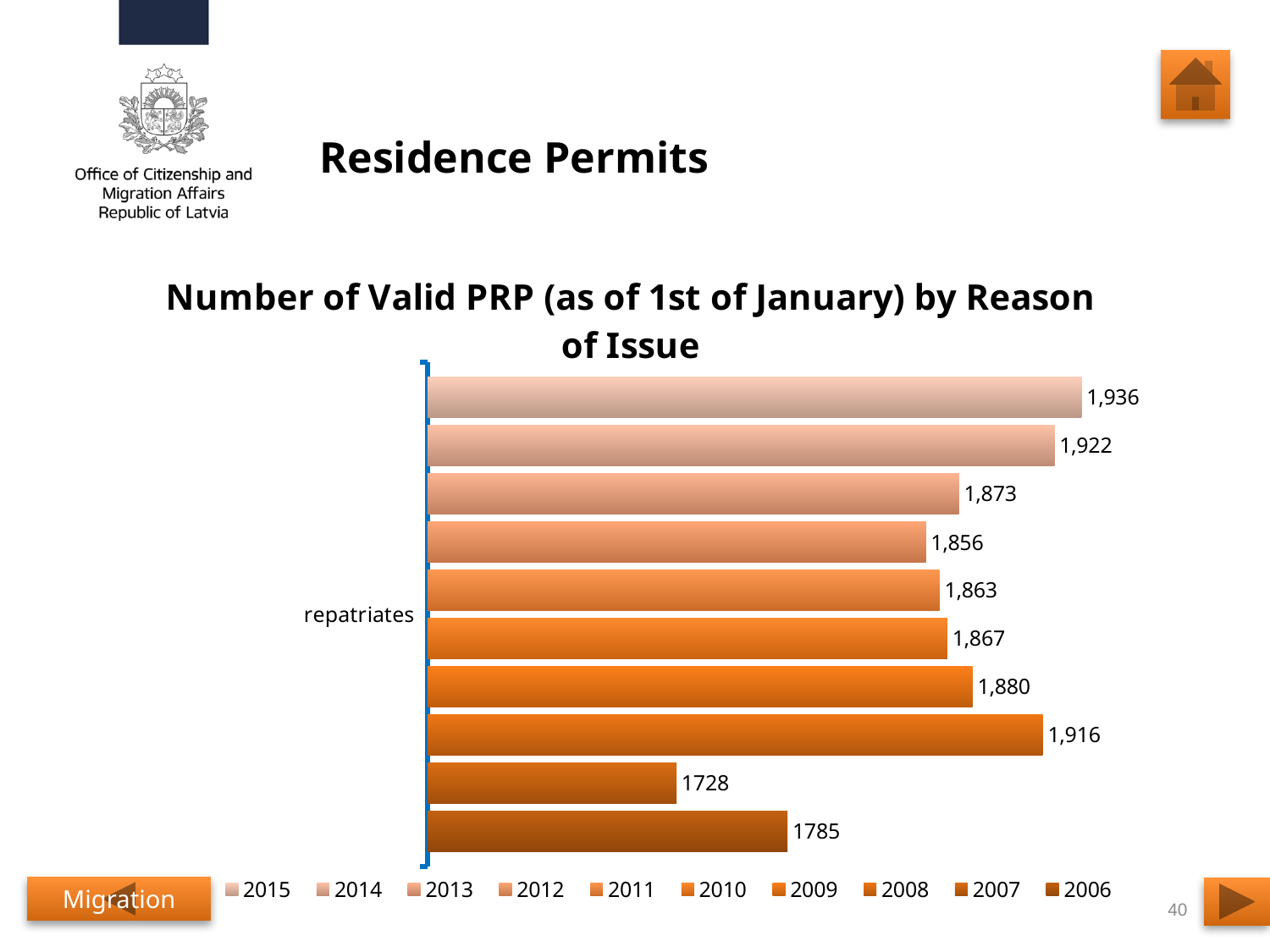
What is the value for repatriates in 2007? 1728 What is the difference between the 2015 value and the 2007 value for repatriates? 208 Which year has the highest number of valid PRP for repatriates? 2015 What is the value for repatriates in 2012? 1,856 How many series does the legend list? 10 What is the value for repatriates in 2015? 1,936 What is the value for repatriates in 2008? 1,916 What is the title of the chart? Number of Valid PRP (as of 1st of January) by Reason of Issue What is the only category shown on the vertical axis? repatriates Which is larger for repatriates, the 2006 value or the 2007 value? 2006 What type of chart is shown on the slide? bar chart Which year has the lowest number of valid PRP for repatriates? 2007